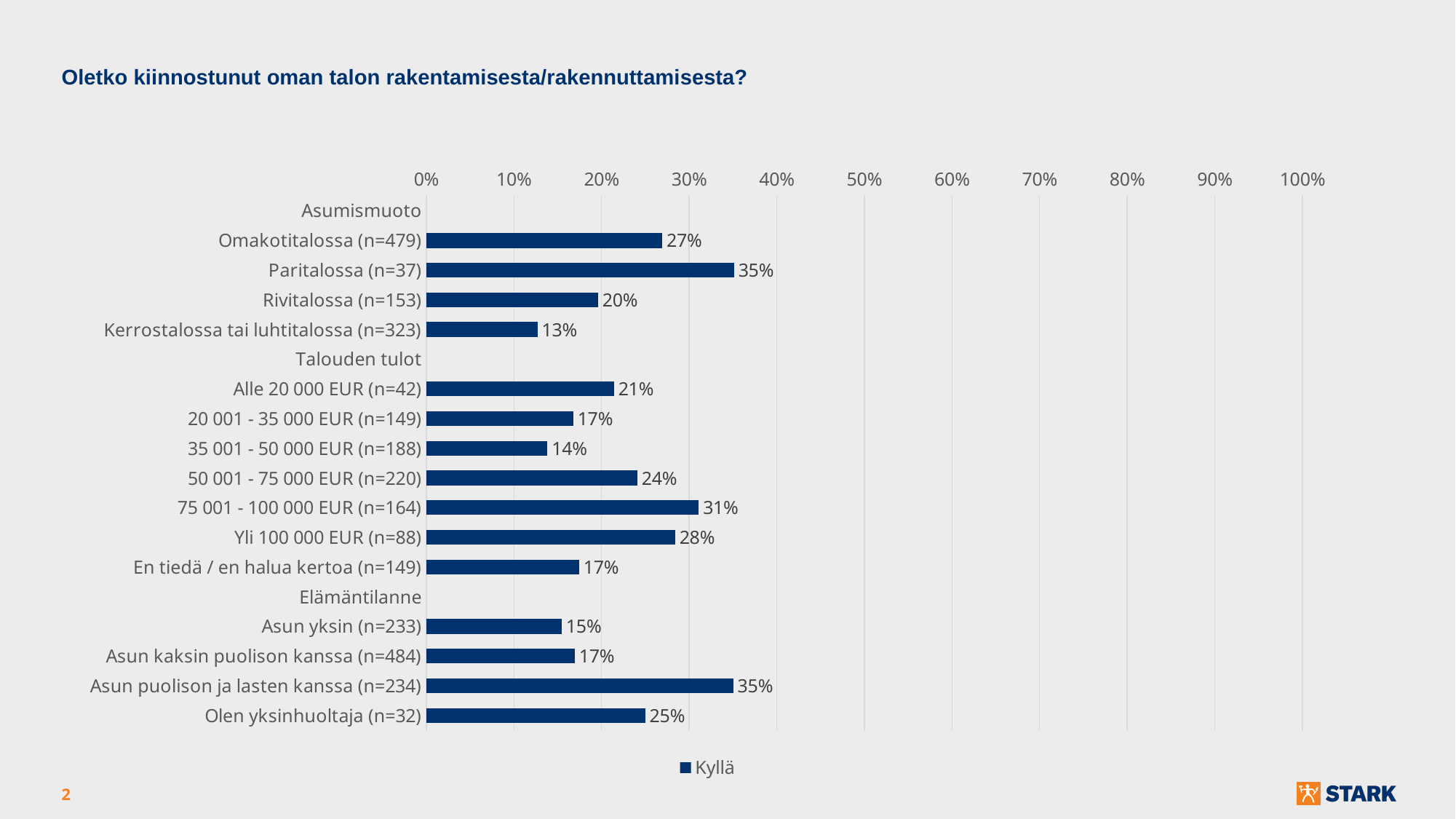
What is the value for Olen yksinhuoltaja (n=32)? 25% Which category has the lowest value in the chart? Kerrostalossa tai luhtitalossa (n=323) Within the Talouden tulot group, which category has the highest value? 75 001 - 100 000 EUR (n=164) Is the value for Yli 100 000 EUR (n=88) greater or less than 20%? greater What is the difference between the values for Paritalossa (n=37) and Rivitalossa (n=153)? 15% What is the value for Omakotitalossa (n=479)? 27% What is the value for 75 001 - 100 000 EUR (n=164)? 31% How many series does the legend list? 1 How many bars are shown in the Talouden tulot group? 7 What is the value for Kerrostalossa tai luhtitalossa (n=323)? 13% Which is larger, the value for Asun yksin (n=233) or the value for Asun kaksin puolison kanssa (n=484)? Asun kaksin puolison kanssa (n=484) What kind of chart is shown on the slide? bar chart